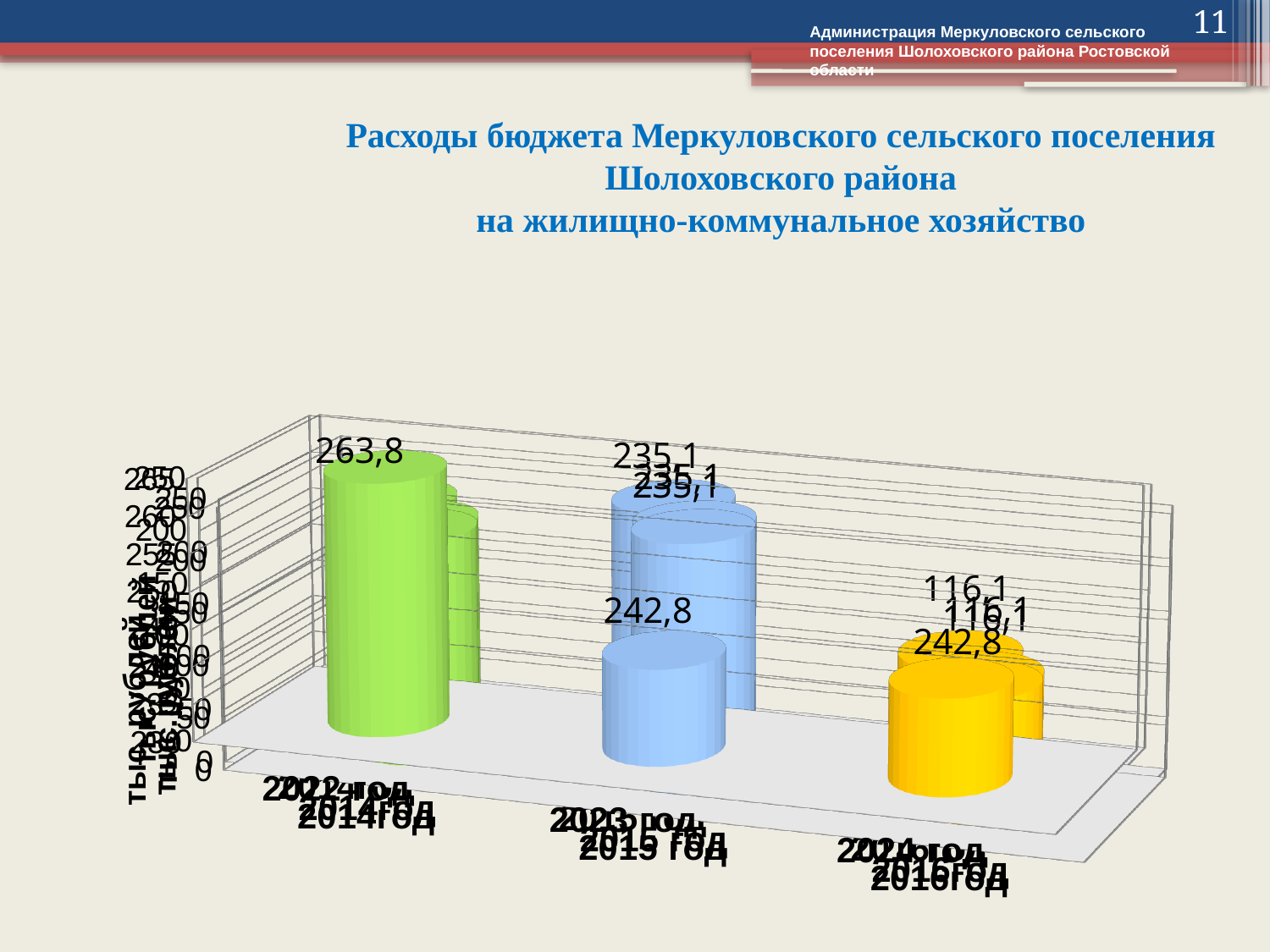
What is the title of the chart on the slide? Расходы бюджета Меркуловского сельского поселения Шолоховского района на жилищно-коммунальное хозяйство Is the value labelled on the tallest green bar greater or less than 250? greater What kind of chart is shown on the slide? bar chart What value is labelled on the tallest green bar in the chart? 263,8 How many different bar colours are used in the chart? 3 Which colour is the tallest bar in the chart? green